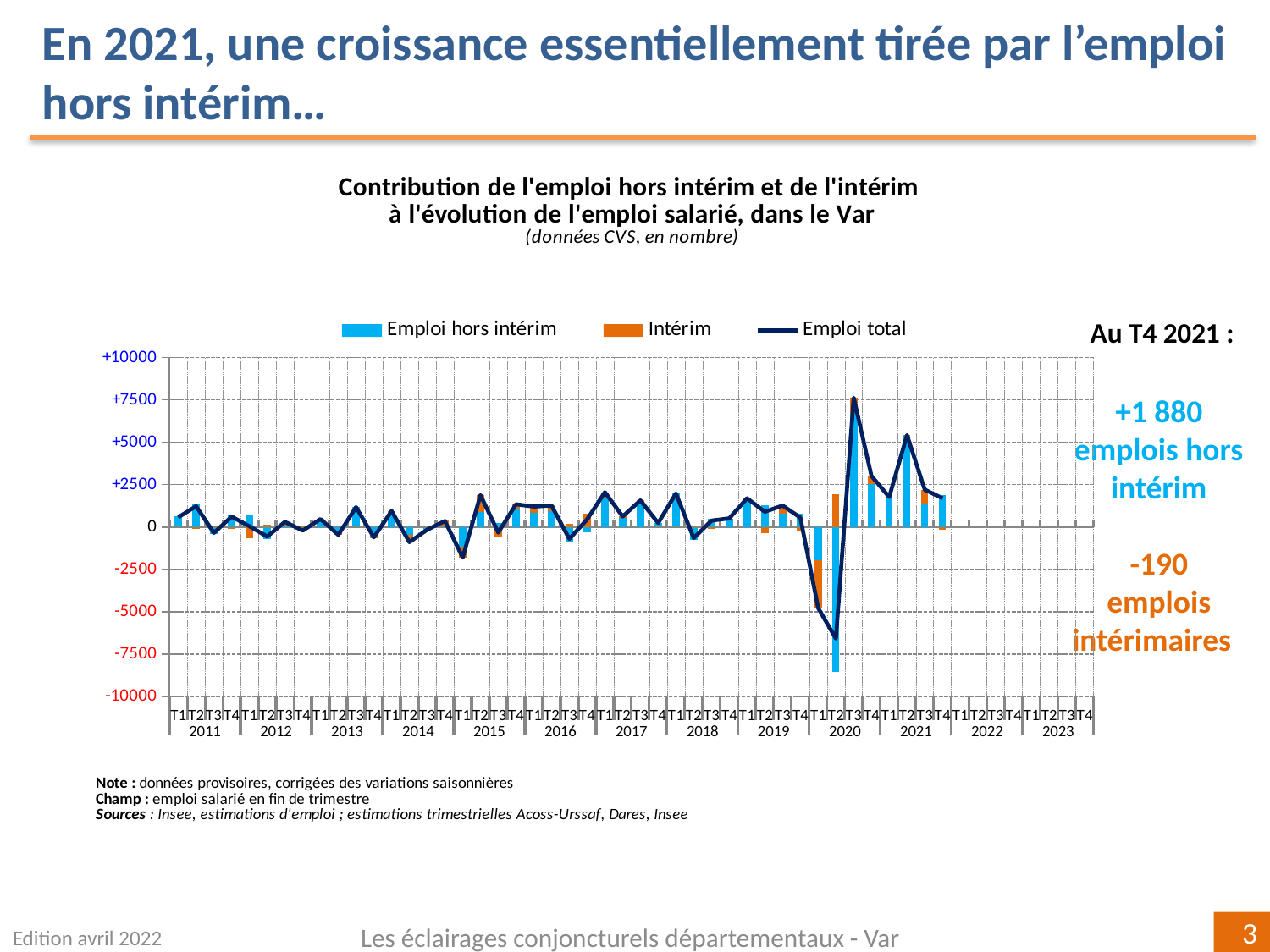
What kind of chart is shown on the slide? A combined bar and line chart Is the value for Emploi total at T3 2020 greater or less than 5000? greater How many years are labelled along the x axis of the chart? 13 What is the value for Intérim at T4 2021? -190 What is the value for Emploi hors intérim at T4 2021? +1 880 Which series is drawn as a line in the chart? Emploi total How many series does the chart legend list? 3 At T4 2021, which is larger: the value for Emploi hors intérim or the value for Intérim? Emploi hors intérim Is the value for Emploi hors intérim at T2 2020 greater or less than -7500? less In which quarter does the Emploi total line reach its highest point? T3 2020 In which quarter does the Emploi total line reach its lowest point? T2 2020